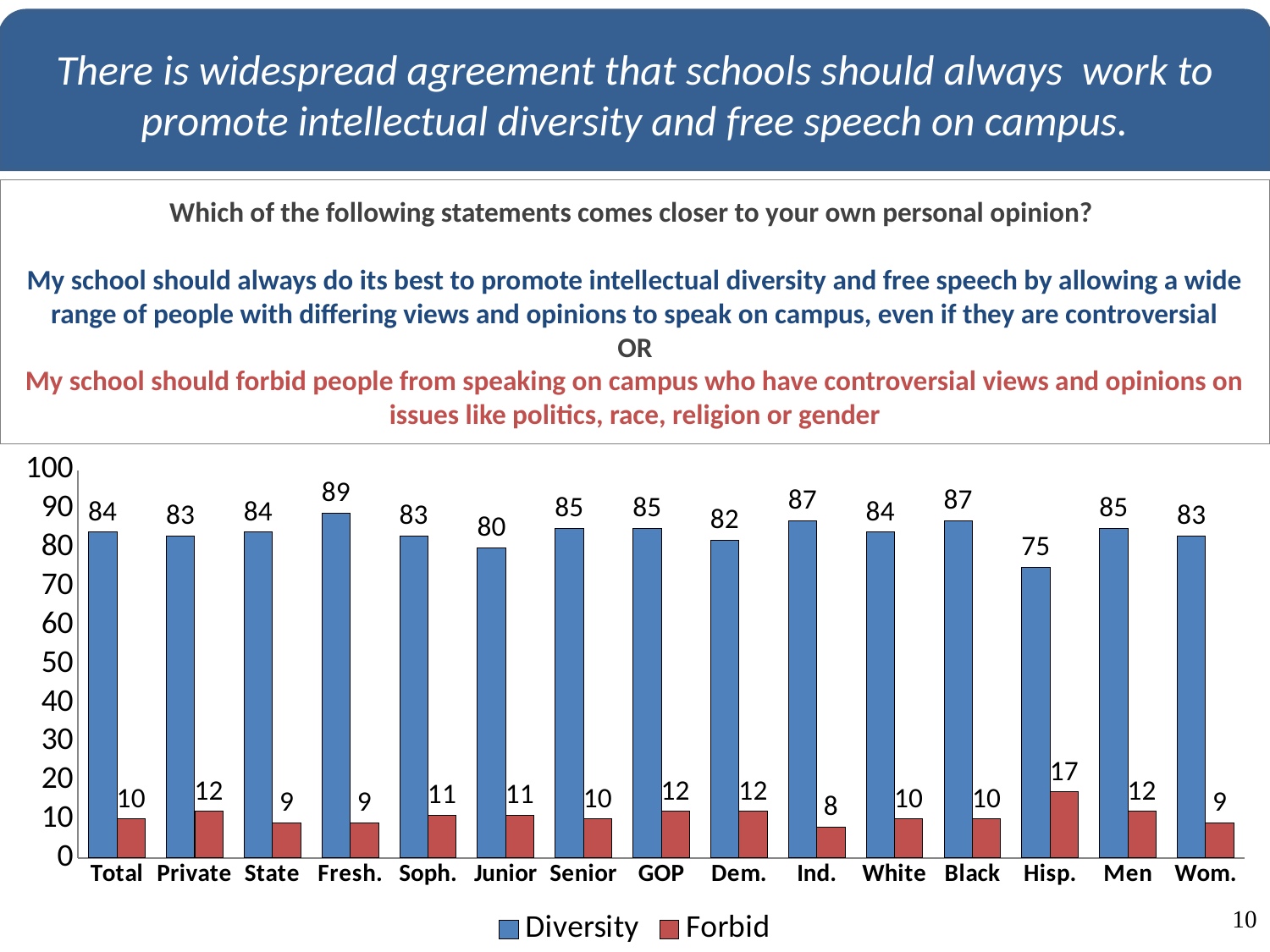
How many series does the legend list? 2 What is the Diversity value for Total? 84 What colour are the Forbid bars? Red How many categories are shown on the x axis? 15 What is the Forbid value for Hisp.? 17 Which category has the highest Forbid value? Hisp. Which is larger, the Diversity value for Fresh. or the Diversity value for Junior? Fresh. What is the difference between the Diversity and Forbid values for Hisp.? 58 Which category has the lowest Diversity value? Hisp. Which category has the lowest Forbid value? Ind. What is the Diversity value for Fresh.? 89 What kind of chart is shown on the slide? Bar chart